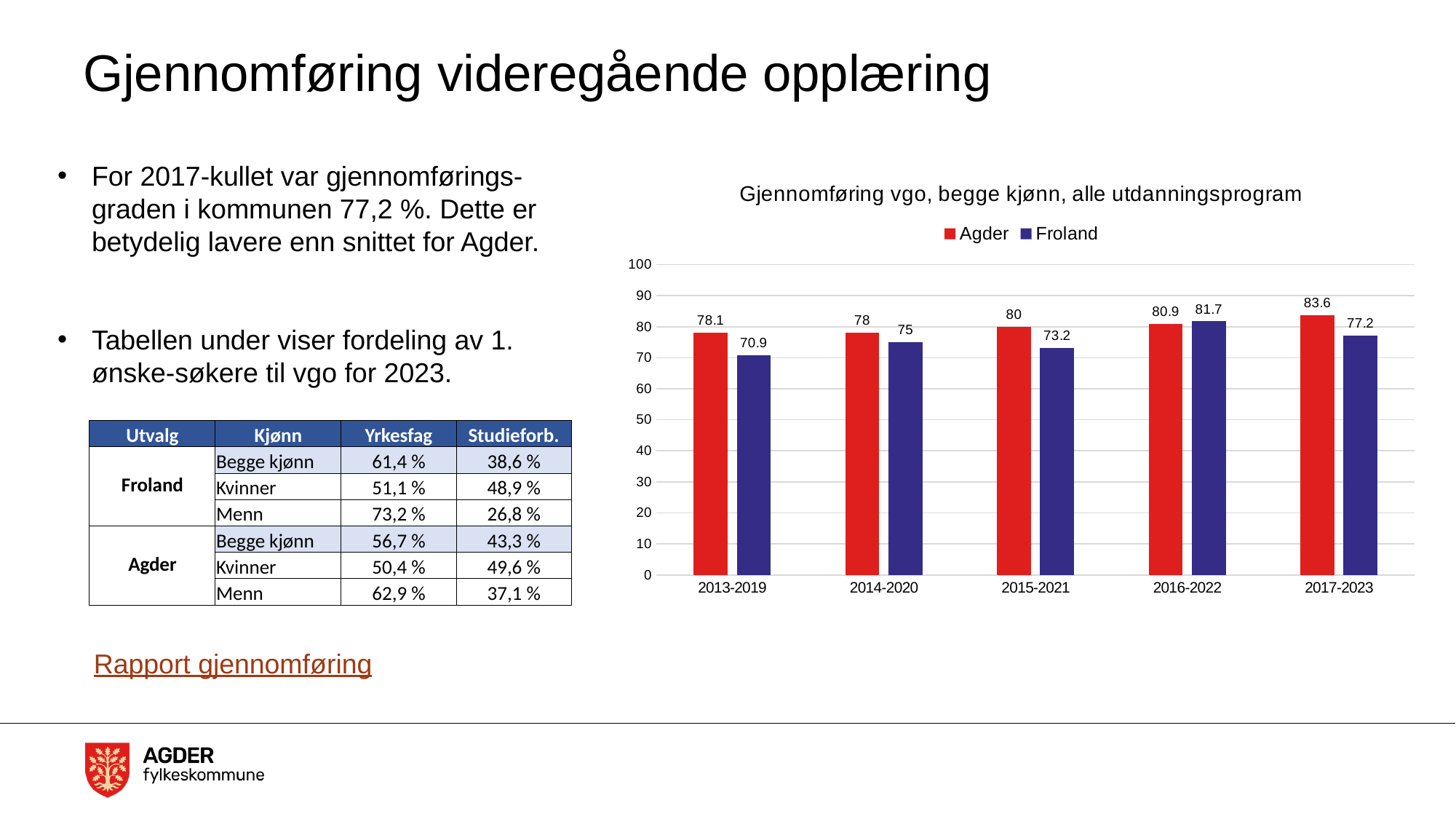
Which period has the highest value for Agder? 2017-2023 How many series does the legend list? 2 What is the difference between Agder and Froland in 2017-2023? 6.4 Is the value for Froland in 2013-2019 greater or less than 80? less What is the difference between Agder and Froland in 2013-2019? 7.2 Which is larger in 2016-2022, Agder or Froland? Froland What kind of chart is shown? bar chart Which period has the lowest value for Froland? 2013-2019 What is the value for Froland in 2017-2023? 77.2 What is the value for Agder in 2013-2019? 78.1 What is the value for Froland in 2015-2021? 73.2 How many periods are shown on the x axis? 5